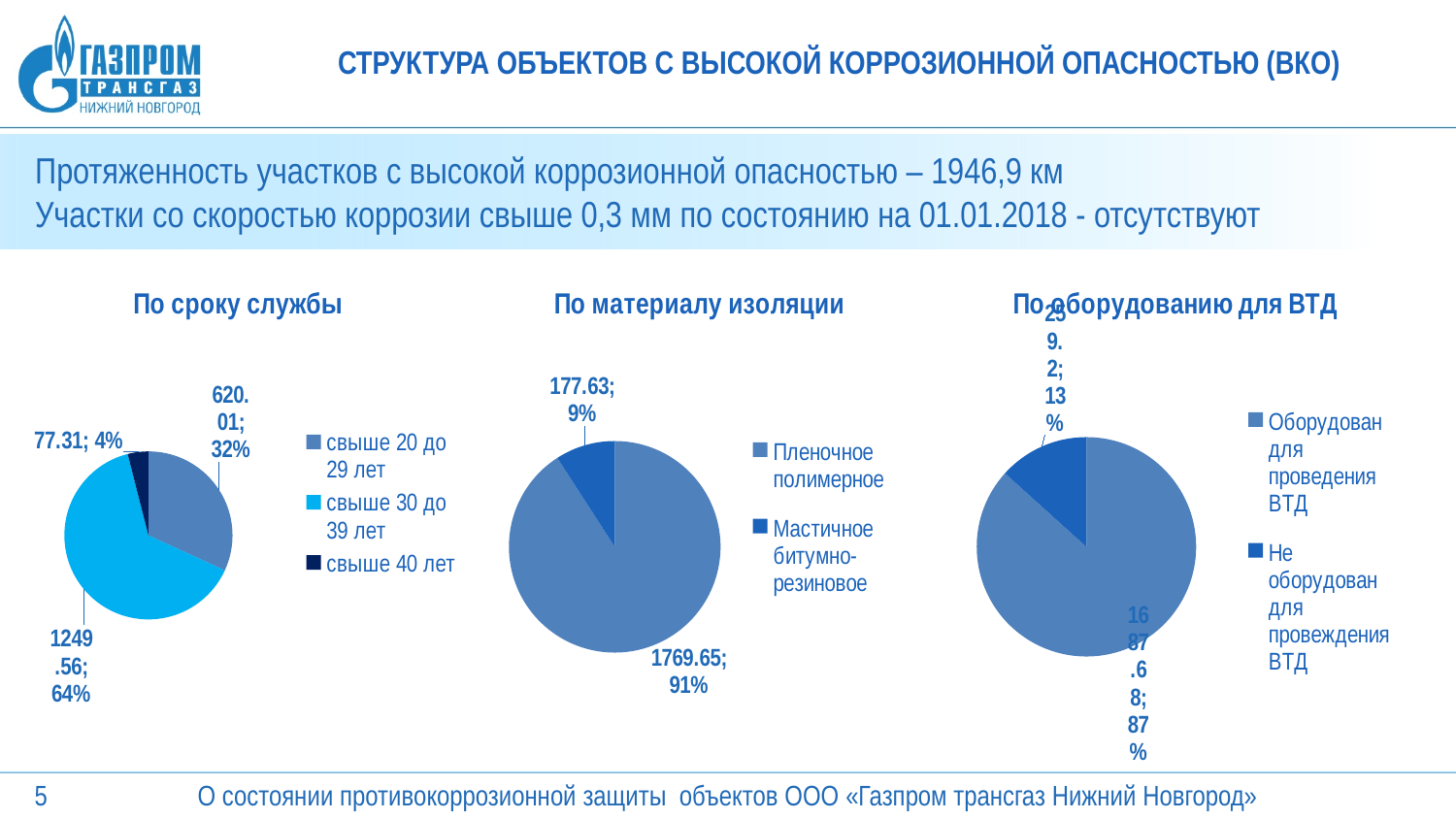
In the "По сроку службы" chart, which category has the smallest slice? свыше 40 лет In the "По сроку службы" chart, what is the value for "свыше 40 лет"? 77.31 In the "По материалу изоляции" chart, what is the difference between the values for "Мастичное битумно-резиновое" and "Пленочное полимерное"? 1592.02 How many categories does the "По сроку службы" chart show? 3 How many entries does the legend of the "По материалу изоляции" chart list? 2 In the "По материалу изоляции" chart, what share of the pie is "Пленочное полимерное"? 91% In the "По материалу изоляции" chart, what is the value for "Мастичное битумно-резиновое"? 177.63 In the "По сроку службы" chart, what is the value for "свыше 30 до 39 лет"? 1249.56 In the "По сроку службы" chart, what share of the pie is "свыше 20 до 29 лет"? 32% In the "По оборудованию для ВТД" chart, which category has the larger slice: "Оборудован для проведения ВТД" or "Не оборудован для провеждения ВТД"? Оборудован для проведения ВТД What kind of chart is used for "По сроку службы"? pie chart In the "По оборудованию для ВТД" chart, what share of the pie is "Не оборудован для провеждения ВТД"? 13%